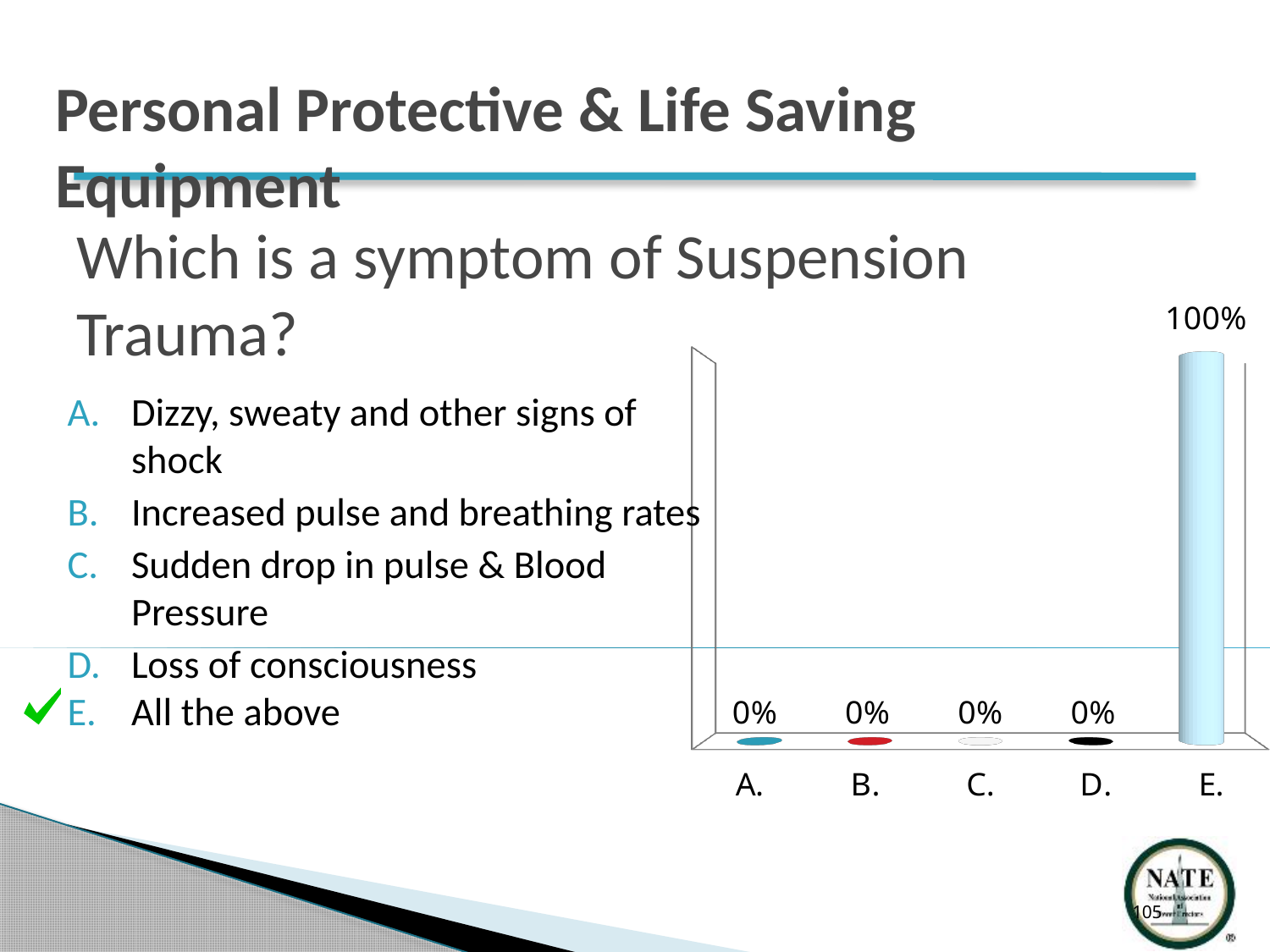
Which category has the highest value in the chart? E. What is the value for category E. in the chart? 100% How many categories are shown on the x axis of the chart? 5 Which is larger, the value for E. or the value for B.? E. What kind of chart is shown on the slide? bar chart What is the value for category A. in the chart? 0% What is the total of the values for A., B., C. and D.? 0% What is the value for category C. in the chart? 0% What is the value for category D. in the chart? 0% What is the label of the last category on the x axis? E. What is the difference between the values for E. and D.? 100%